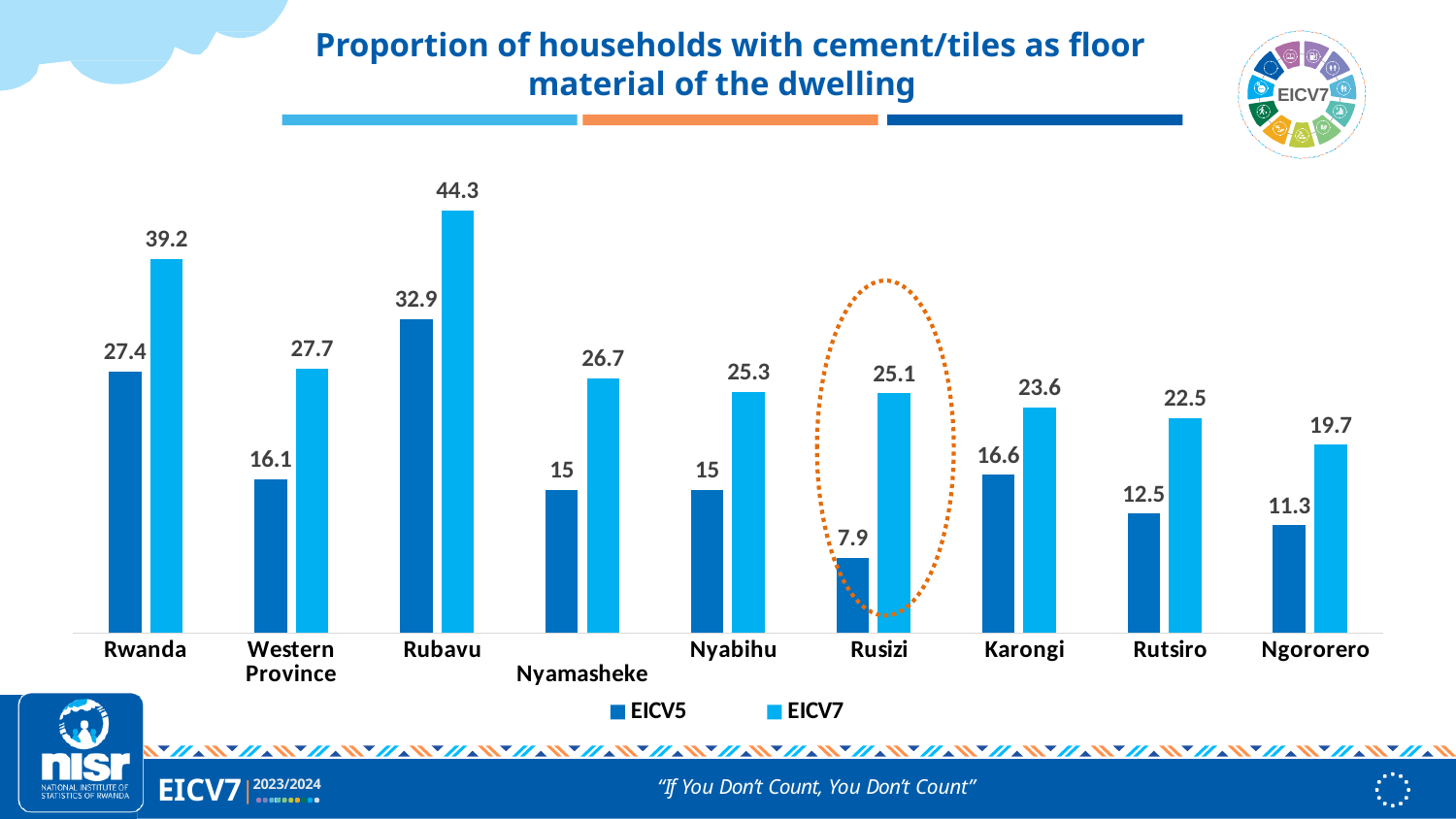
What is the EICV5 value for Karongi? 16.6 How many series does the legend list? 2 What is the difference between the EICV7 values for Rwanda and Ngororero? 19.5 What kind of chart is shown on the slide? Bar chart Which category has the highest EICV7 value? Rubavu What is the EICV7 value for Rubavu? 44.3 What is the EICV5 value for Rusizi? 7.9 Which category has the lowest EICV5 value? Rusizi What is the EICV7 value for Western Province? 27.7 How many categories are shown on the x axis? 9 Which is larger, the EICV5 value for Rutsiro or the EICV5 value for Ngororero? Rutsiro What is the difference between the EICV7 and EICV5 values for Rusizi? 17.2